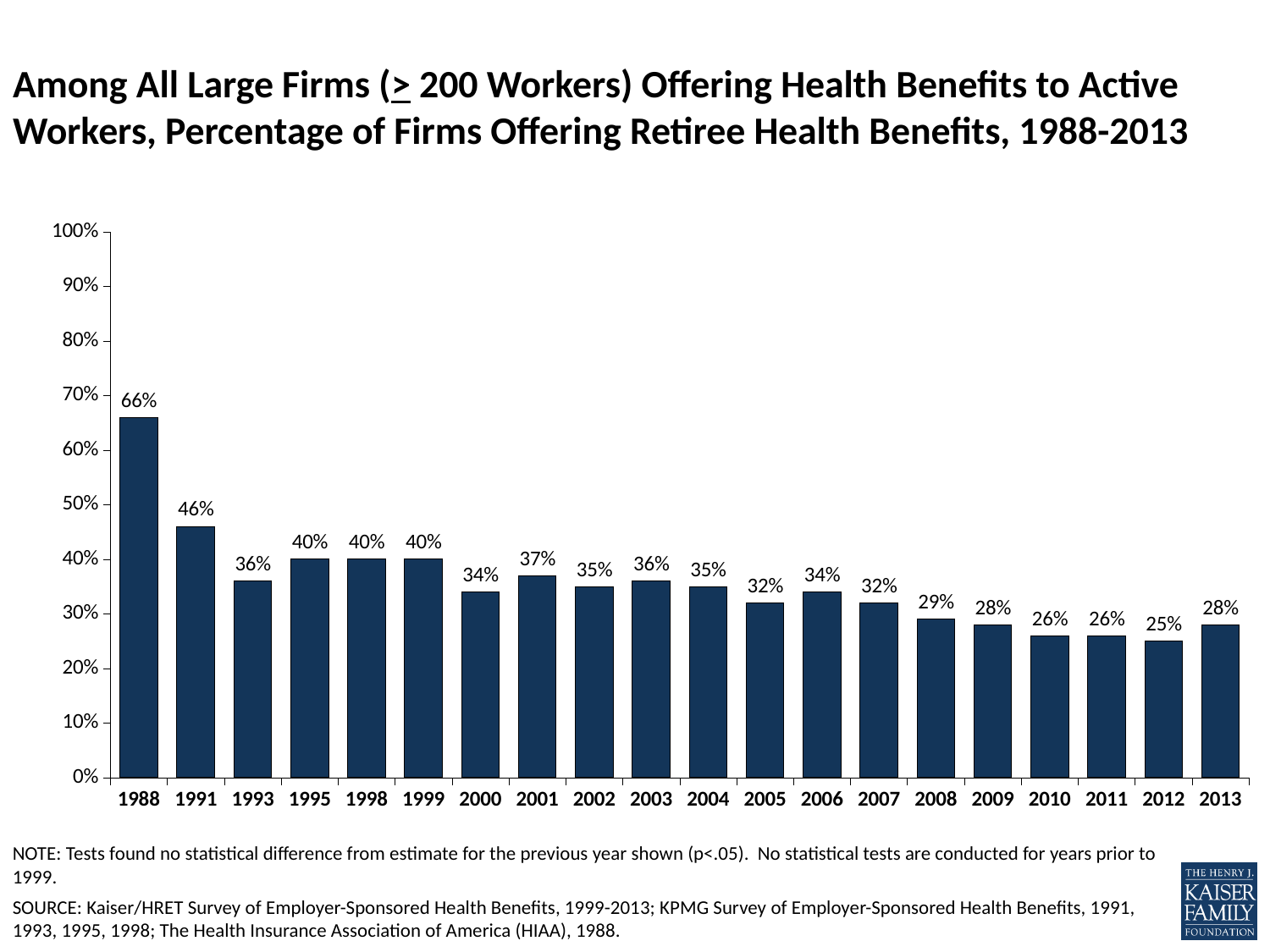
Which year has the lowest percentage of firms offering retiree health benefits? 2012 Do the values generally rise or fall from 1988 to 2013? Fall Which year has a higher value, 2000 or 2003? 2003 Is the value for 2005 greater or less than 40%? less What is the difference between the 1988 value and the 1991 value? 20 percentage points How many years are shown on the x axis? 20 What is the value shown for 2013? 28% What is the difference between the 2008 value and the 2012 value? 4 percentage points What percentage of large firms offered retiree health benefits in 1988? 66% What kind of chart is shown on the slide? Bar chart What percentage is shown for 2001? 37% Which year has the highest percentage of firms offering retiree health benefits? 1988